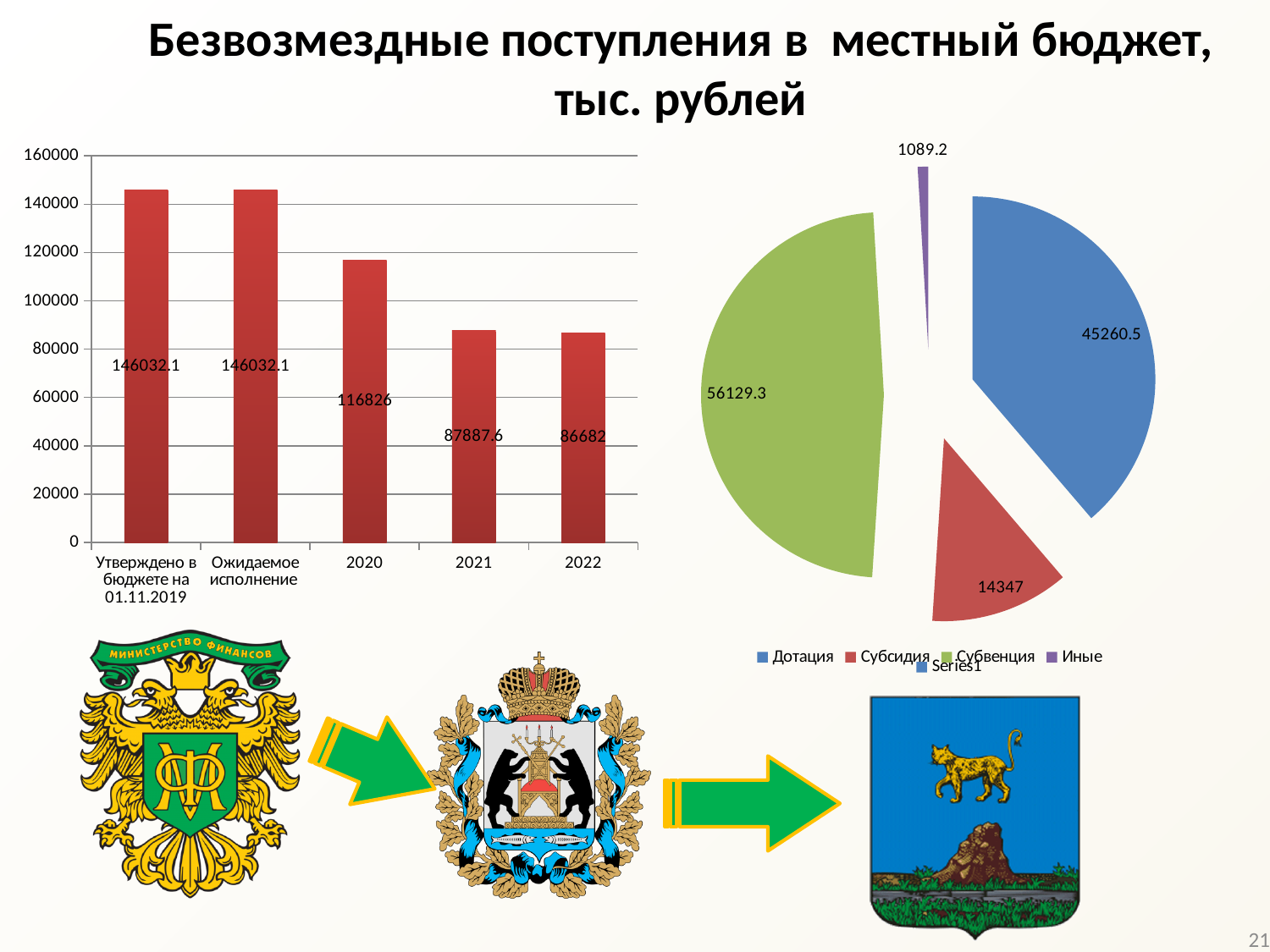
In the pie chart on the right, which category has the largest slice? Субвенция In the bar chart on the left, do the values rise or fall from 2020 to 2022? fall In the pie chart on the right, which is larger: Дотация or Субсидия? Дотация In the bar chart on the left, how many categories are shown on the x axis? 5 In the bar chart on the left, what is the difference between the value for 'Ожидаемое исполнение' and the value for 2020? 29206.1 What type of chart is the chart on the right of the slide? pie chart In the bar chart on the left, what is the value for 2020? 116826 In the bar chart on the left, which category has the lowest value? 2022 In the pie chart on the right, what is the value for Субсидия? 14347 What type of chart is the chart on the left of the slide? bar chart In the pie chart on the right, what is the difference between the values for Субвенция and Дотация? 10868.8 In the bar chart on the left, what is the value for 2022? 86682